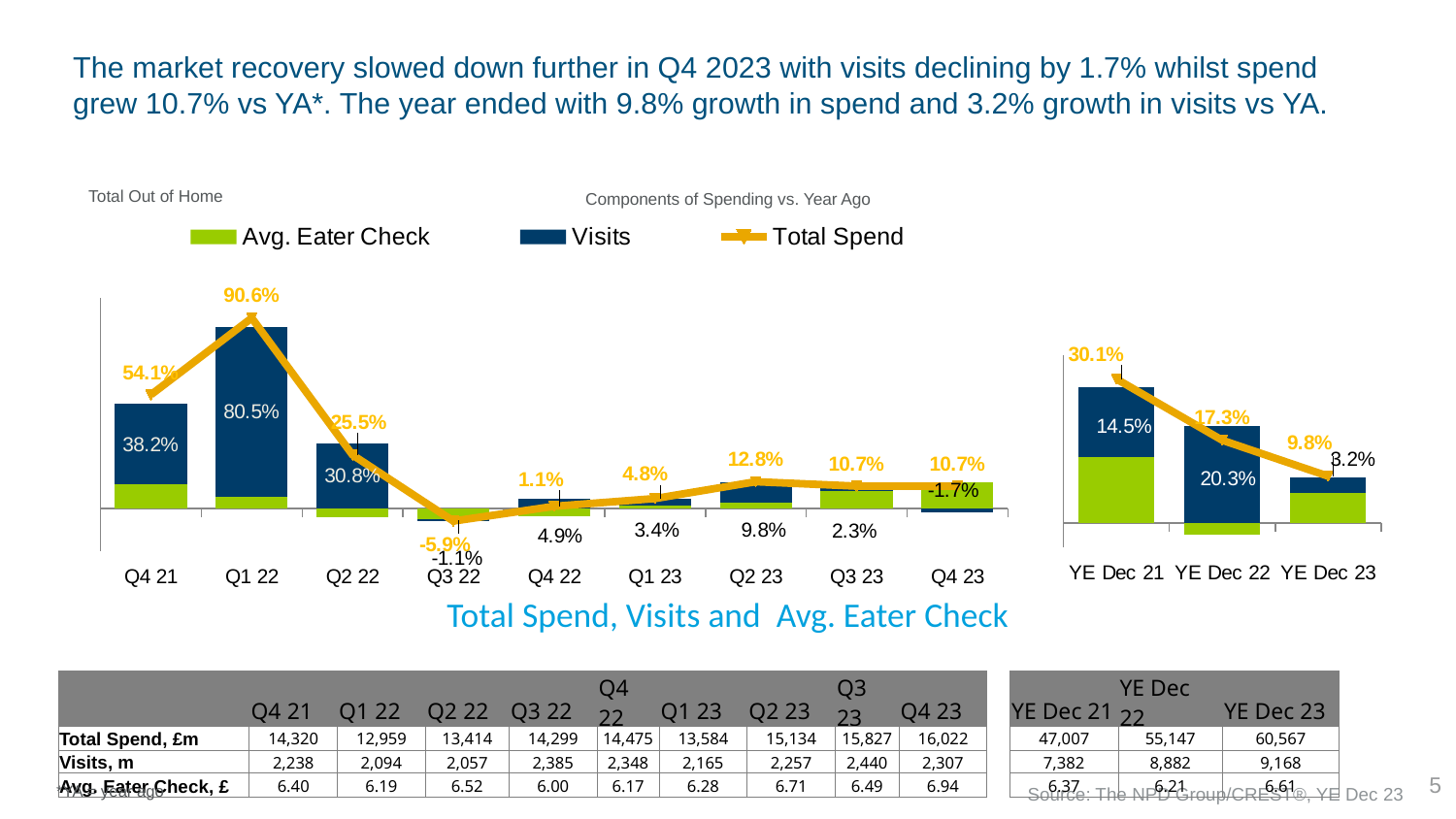
How many series does the legend list? 3 In the left chart (quarterly), which quarter has the lowest Total Spend value? Q3 22 In the right chart (YE Dec), what is the Total Spend value for YE Dec 23? 9.8% How many quarters are shown on the x axis of the left chart? 9 In the left chart (quarterly), which quarter has the larger Total Spend value, Q2 23 or Q3 23? Q2 23 In the right chart (YE Dec), does the Total Spend line rise or fall from YE Dec 21 to YE Dec 23? Fall What kind of chart is used on this slide? Stacked bar chart with a line In the left chart (quarterly), what is the Visits value for Q4 23? -1.7% In the left chart (quarterly), what is the Total Spend value for Q1 22? 90.6% In the right chart (YE Dec), what is the Visits value for YE Dec 22? 20.3% In the left chart (quarterly), what is the difference between the Total Spend values for Q1 22 and Q4 21? 36.5 percentage points In the left chart (quarterly), which quarter has the highest Total Spend value? Q1 22